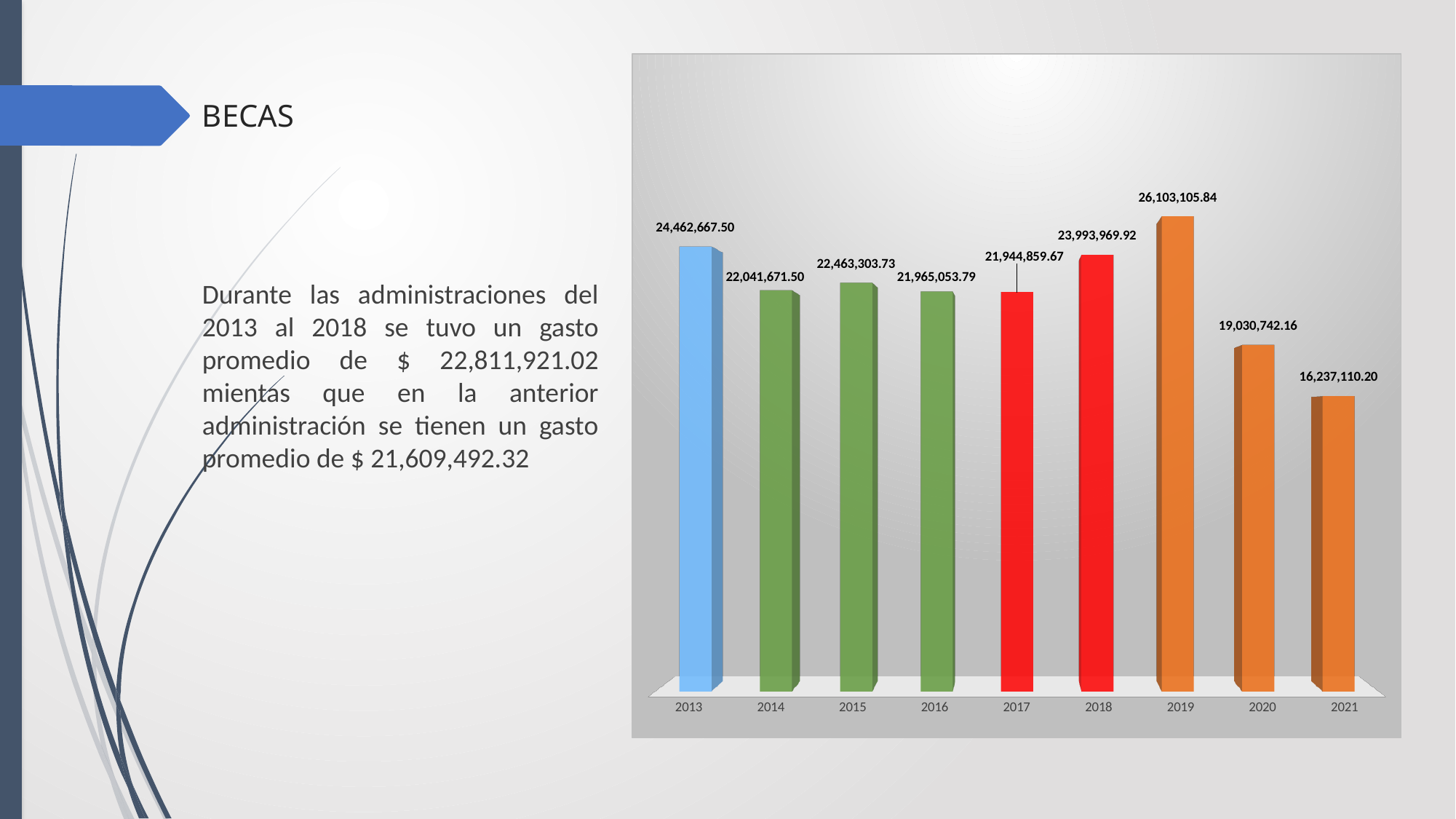
What is the value shown for 2019? 26,103,105.84 Which is larger, the value for 2018 or the value for 2017? 2018 What is the value shown for 2013? 24,462,667.50 What is the difference between the values for 2019 and 2021? 9,865,995.64 What is the value shown for 2021? 16,237,110.20 What kind of chart is shown on the slide? Bar chart Which year has the lowest value? 2021 Do the values rise or fall from 2019 to 2021? Fall How many years are shown on the x axis? 9 Which year has the highest value? 2019 What is the difference between the values for 2013 and 2014? 2,420,996.00 What is the value shown for 2017? 21,944,859.67